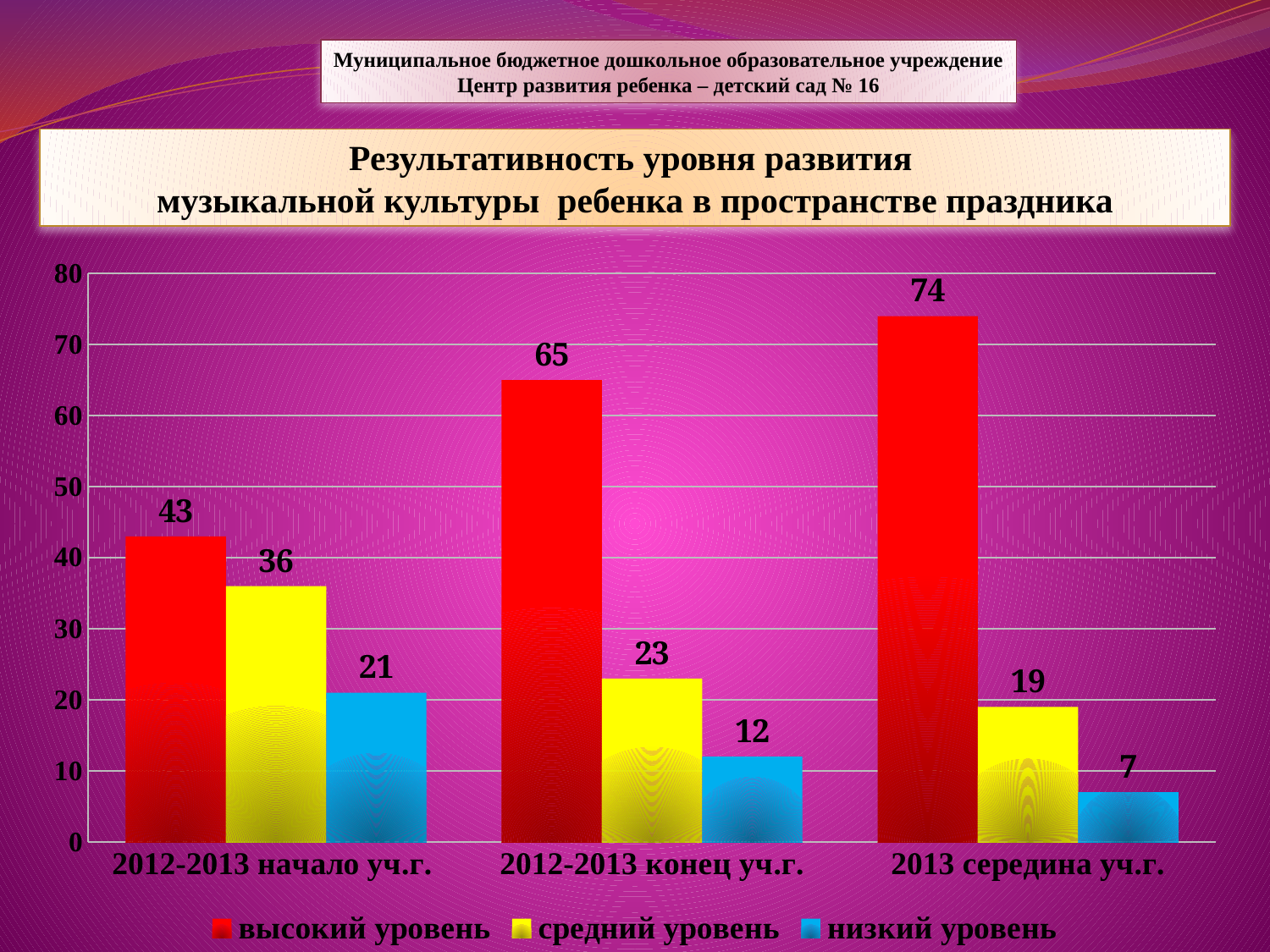
What is the difference between высокий уровень in 2013 середина уч.г. and in 2012-2013 начало уч.г.? 31 What is the value for средний уровень in 2012-2013 конец уч.г.? 23 How many periods are shown on the x axis? 3 In which period is низкий уровень lowest? 2013 середина уч.г. How many series does the legend list? 3 Is the value for высокий уровень in 2012-2013 конец уч.г. greater or less than 60? greater What kind of chart is shown? bar chart Does средний уровень rise or fall across the periods from left to right? fall What is the value for высокий уровень in 2012-2013 начало уч.г.? 43 What is the value for низкий уровень in 2013 середина уч.г.? 7 In which period is высокий уровень highest? 2013 середина уч.г. Which is larger: средний уровень in 2012-2013 начало уч.г. or низкий уровень in 2012-2013 начало уч.г.? средний уровень